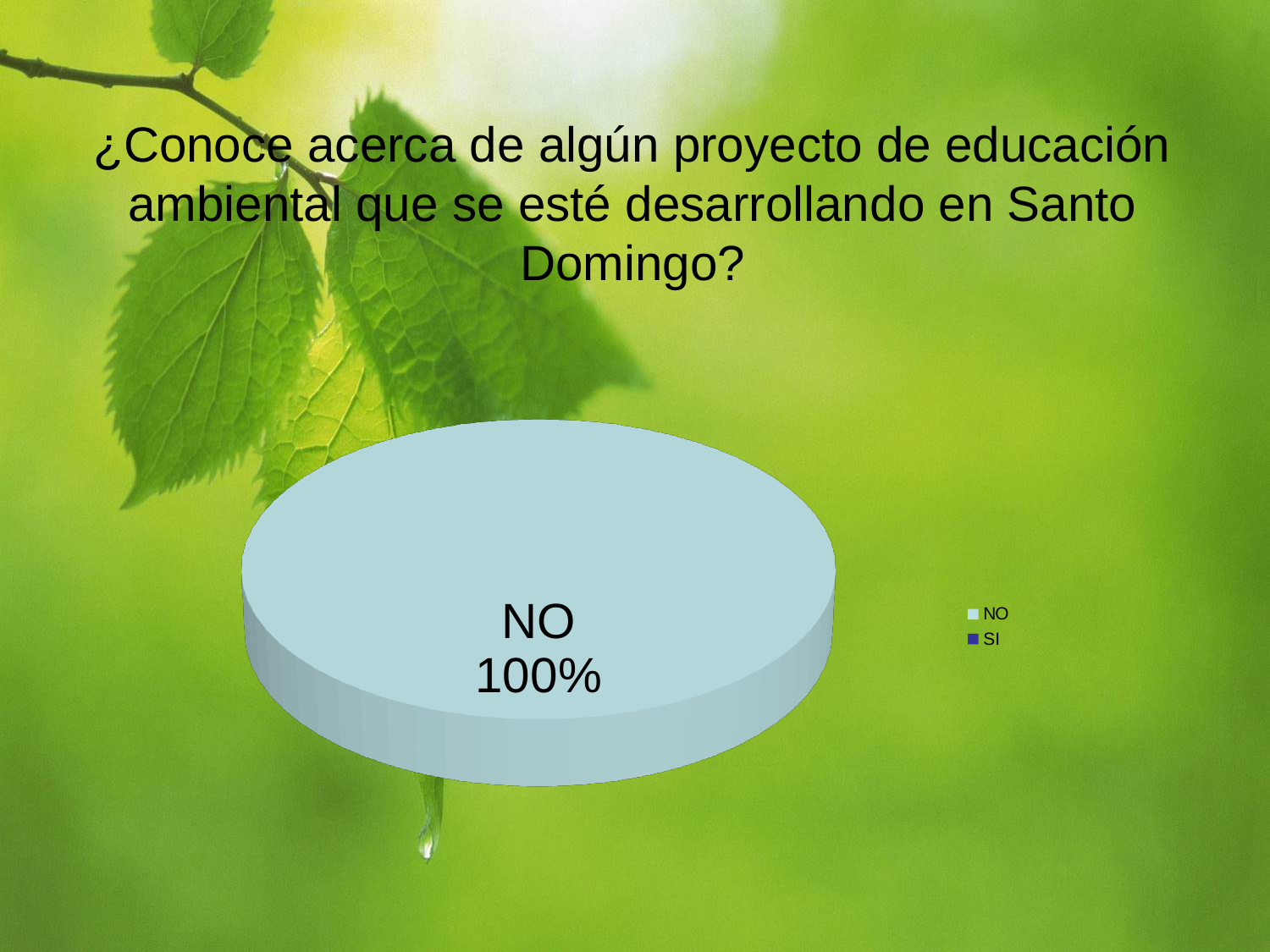
What kind of chart is shown on the slide? pie chart Is the share for NO greater or less than 50%? greater Which category has the largest share of the pie? NO What are the two categories listed in the legend? NO and SI Which category is shown with the larger share, NO or SI? NO How many entries does the legend list? 2 What share of the pie does the NO slice represent? 100% What is the question shown as the title above the chart? ¿Conoce acerca de algún proyecto de educación ambiental que se esté desarrollando en Santo Domingo?